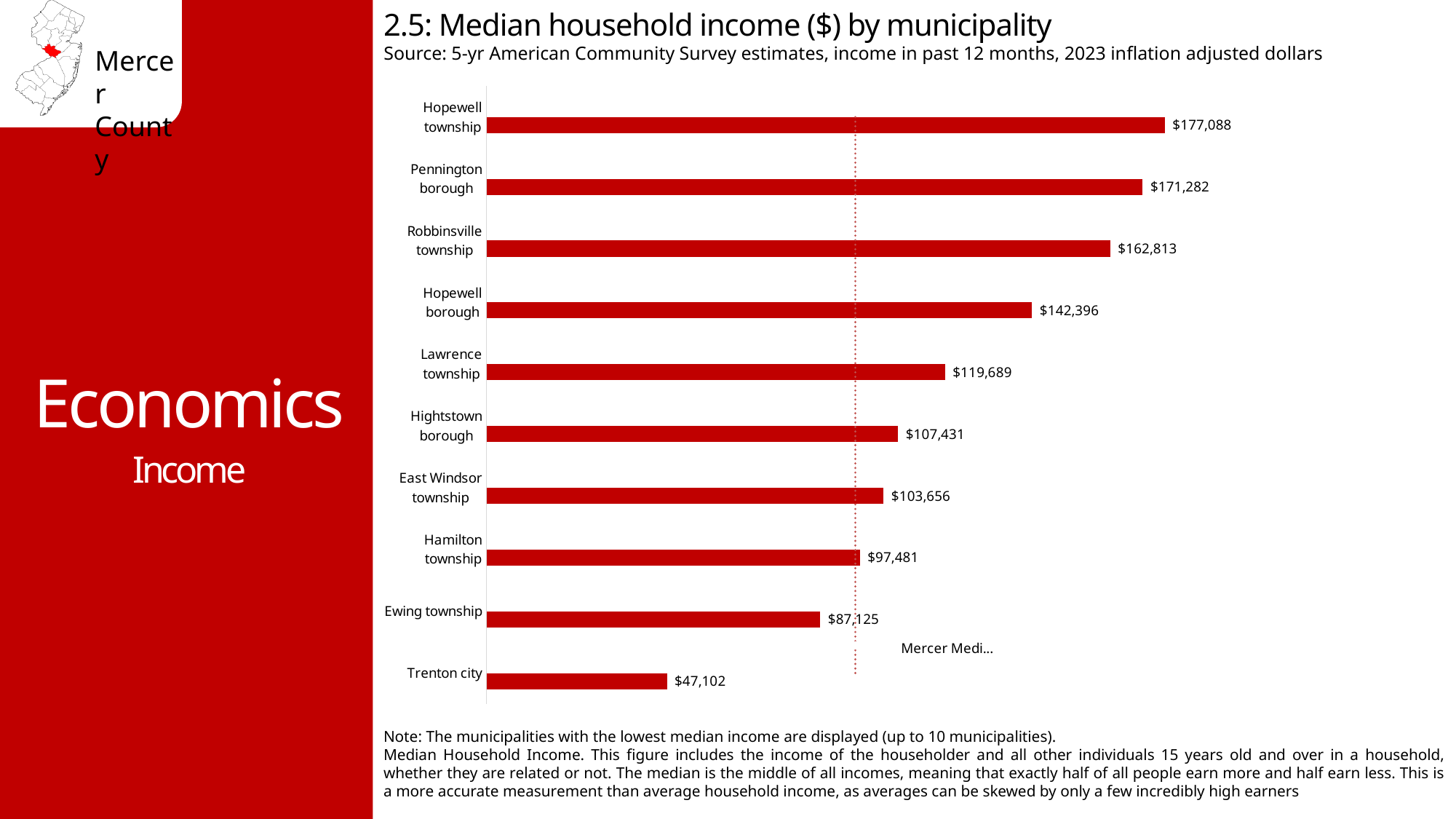
Which municipality has the lowest median household income? Trenton city What is the median household income for Trenton city? $47,102 What is the title of the chart? 2.5: Median household income ($) by municipality What is the difference in median household income between Hopewell township and Pennington borough? $5,806 What is the median household income for Lawrence township? $119,689 What is the median household income for Ewing township? $87,125 Which municipality has the highest median household income? Hopewell township What kind of chart is used to show median household income by municipality? Bar chart How many municipalities are shown in the chart? 10 What is the median household income for Hopewell township? $177,088 What is the difference in median household income between Hamilton township and Trenton city? $50,379 Which has a higher median household income, Hightstown borough or East Windsor township? Hightstown borough